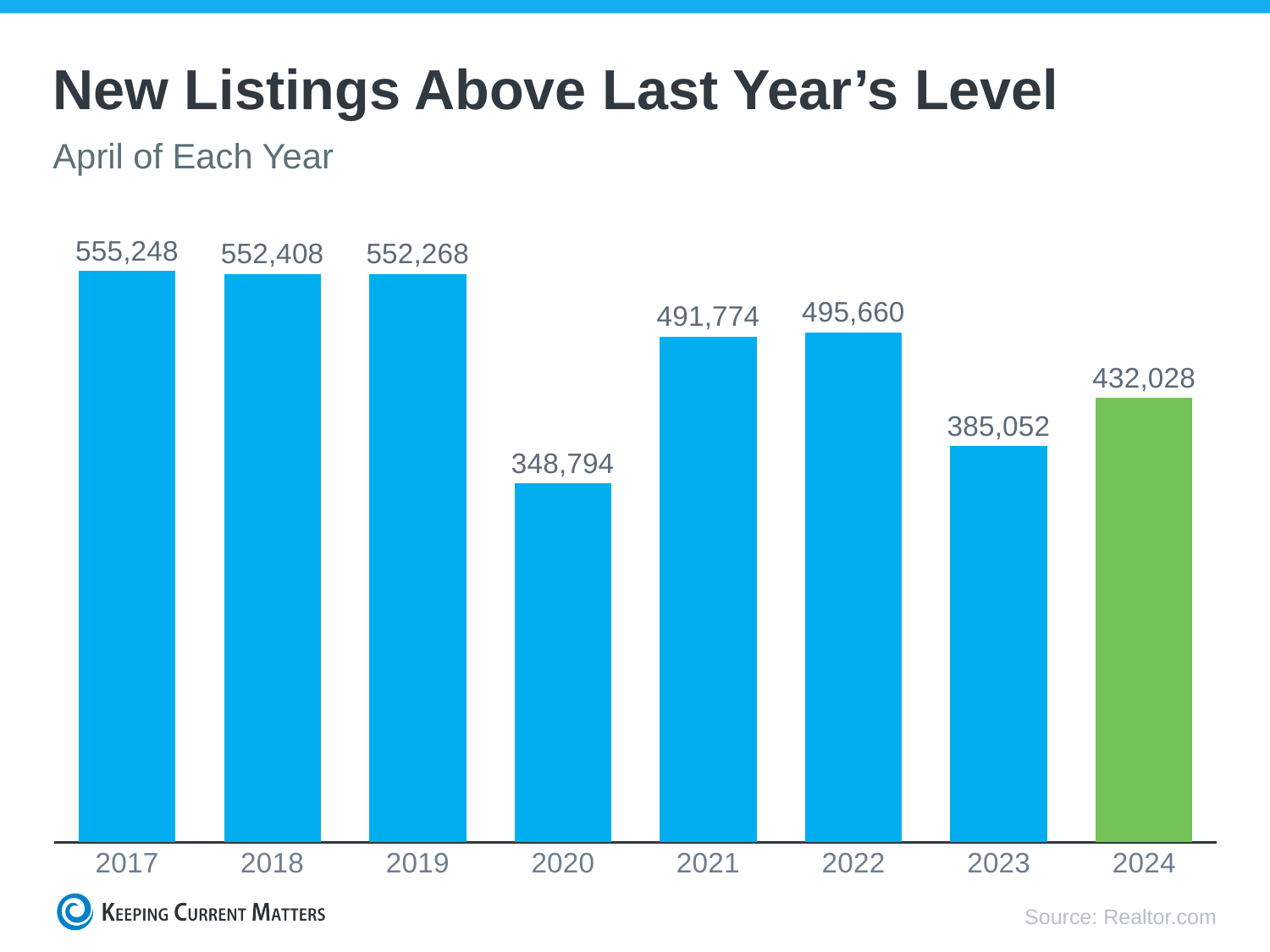
Which year has the lowest value? 2020 What is the value for 2020? 348,794 Which year's bar is coloured green? 2024 How many years are shown on the chart? 8 What is the value for 2024? 432,028 What is the value for 2023? 385,052 Do the values rise or fall from 2022 to 2023? Fall What kind of chart is this? Bar chart What is the difference between the values for 2022 and 2021? 3,886 Which is larger, the value for 2021 or the value for 2024? 2021 What is the difference between the values for 2024 and 2023? 46,976 Which year has the highest value? 2017